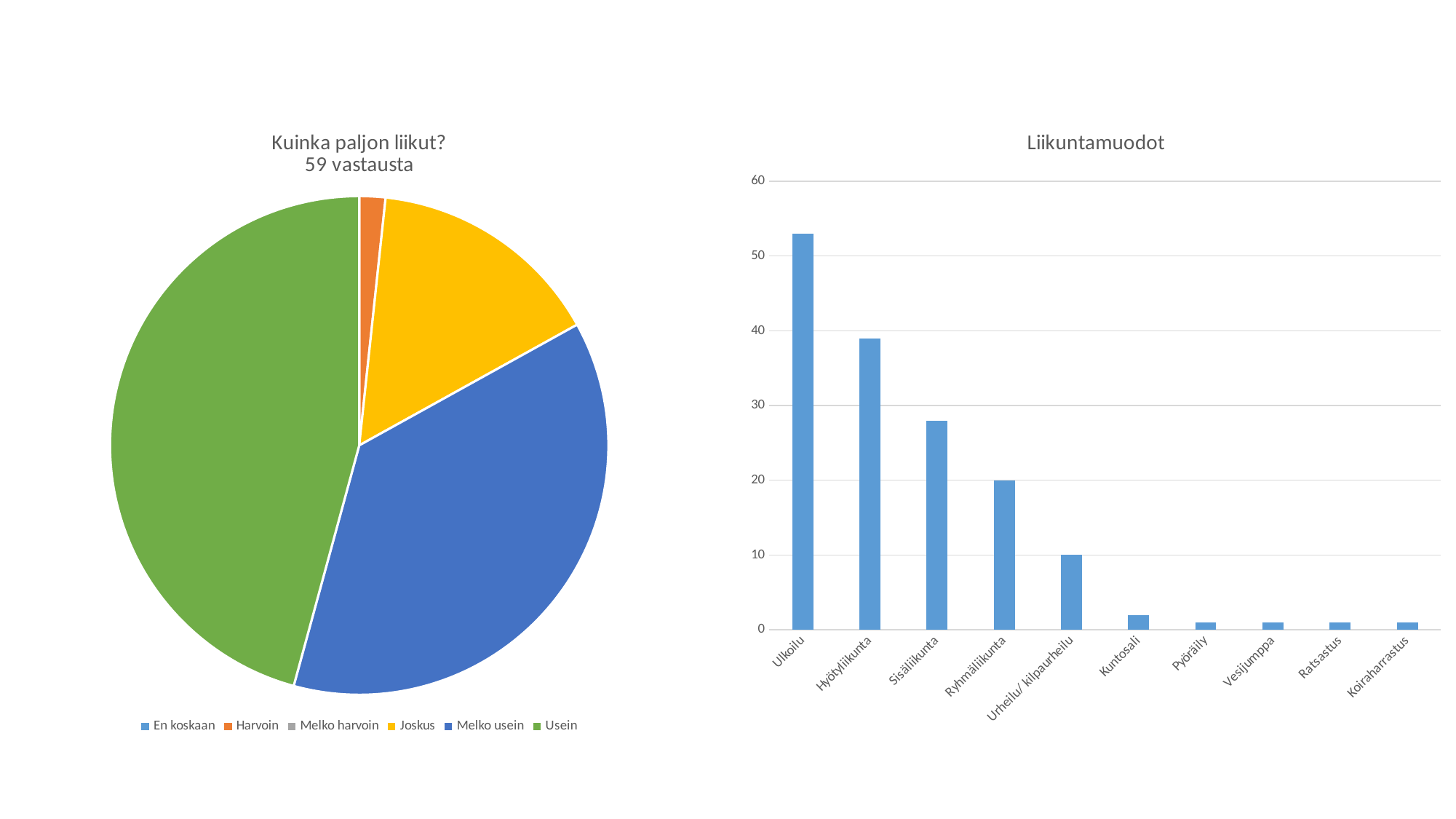
In the 'Liikuntamuodot' chart, is the value for Sisäliikunta greater or less than 30? less In the 'Liikuntamuodot' chart, is the value for Ulkoilu greater or less than 50? greater In the 'Kuinka paljon liikut?' pie chart, which category has the largest slice? Usein In the 'Liikuntamuodot' chart, how many categories are shown on the x axis? 10 What kind of chart is the 'Kuinka paljon liikut?' chart on the left? pie chart How many entries does the legend of the 'Kuinka paljon liikut?' pie chart list? 6 In the 'Liikuntamuodot' chart, what is the value for Urheilu/ kilpaurheilu? 10 In the 'Liikuntamuodot' chart, which is larger, Hyötyliikunta or Sisäliikunta? Hyötyliikunta In the 'Liikuntamuodot' chart, what is the value for Ryhmäliikunta? 20 What kind of chart is the 'Liikuntamuodot' chart on the right? bar chart In the 'Liikuntamuodot' chart, which category has the highest value? Ulkoilu